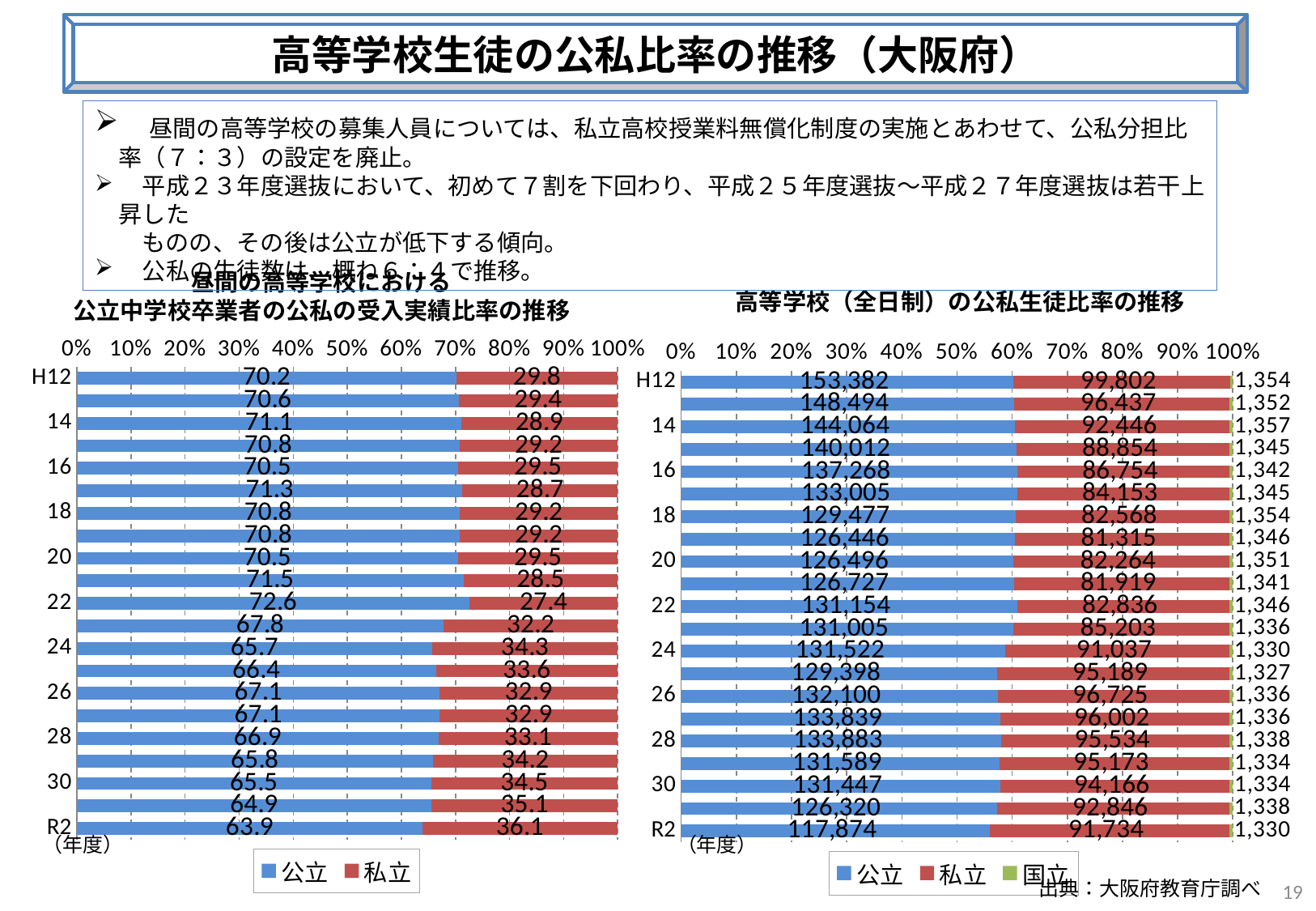
In the right chart (高等学校（全日制）の公私生徒比率の推移), what is the 国立 value for R2? 1,330 In the left chart (昼間の高等学校における公立中学校卒業者の公私の受入実績比率の推移), which year has the highest 公立 value? 22 What kind of chart is the right chart (高等学校（全日制）の公私生徒比率の推移)? Stacked bar chart In the right chart (高等学校（全日制）の公私生徒比率の推移), what is the 公立 value for H12? 153,382 In the left chart (昼間の高等学校における公立中学校卒業者の公私の受入実績比率の推移), what is the 私立 value for R2? 36.1 In the left chart (昼間の高等学校における公立中学校卒業者の公私の受入実績比率の推移), what is the 公立 value for H12? 70.2 In the right chart (高等学校（全日制）の公私生徒比率の推移), how many series does the legend list? 3 In the left chart (昼間の高等学校における公立中学校卒業者の公私の受入実績比率の推移), what is the difference between the 公立 value for H12 and the 公立 value for R2? 6.3 In the left chart (昼間の高等学校における公立中学校卒業者の公私の受入実績比率の推移), which year has the lowest 公立 value? R2 In the right chart (高等学校（全日制）の公私生徒比率の推移), which is larger: the 私立 value for 24 or the 私立 value for 26? 26 In the right chart (高等学校（全日制）の公私生徒比率の推移), which year has the lowest 公立 value? R2 In the left chart (昼間の高等学校における公立中学校卒業者の公私の受入実績比率の推移), how many series does the legend list? 2